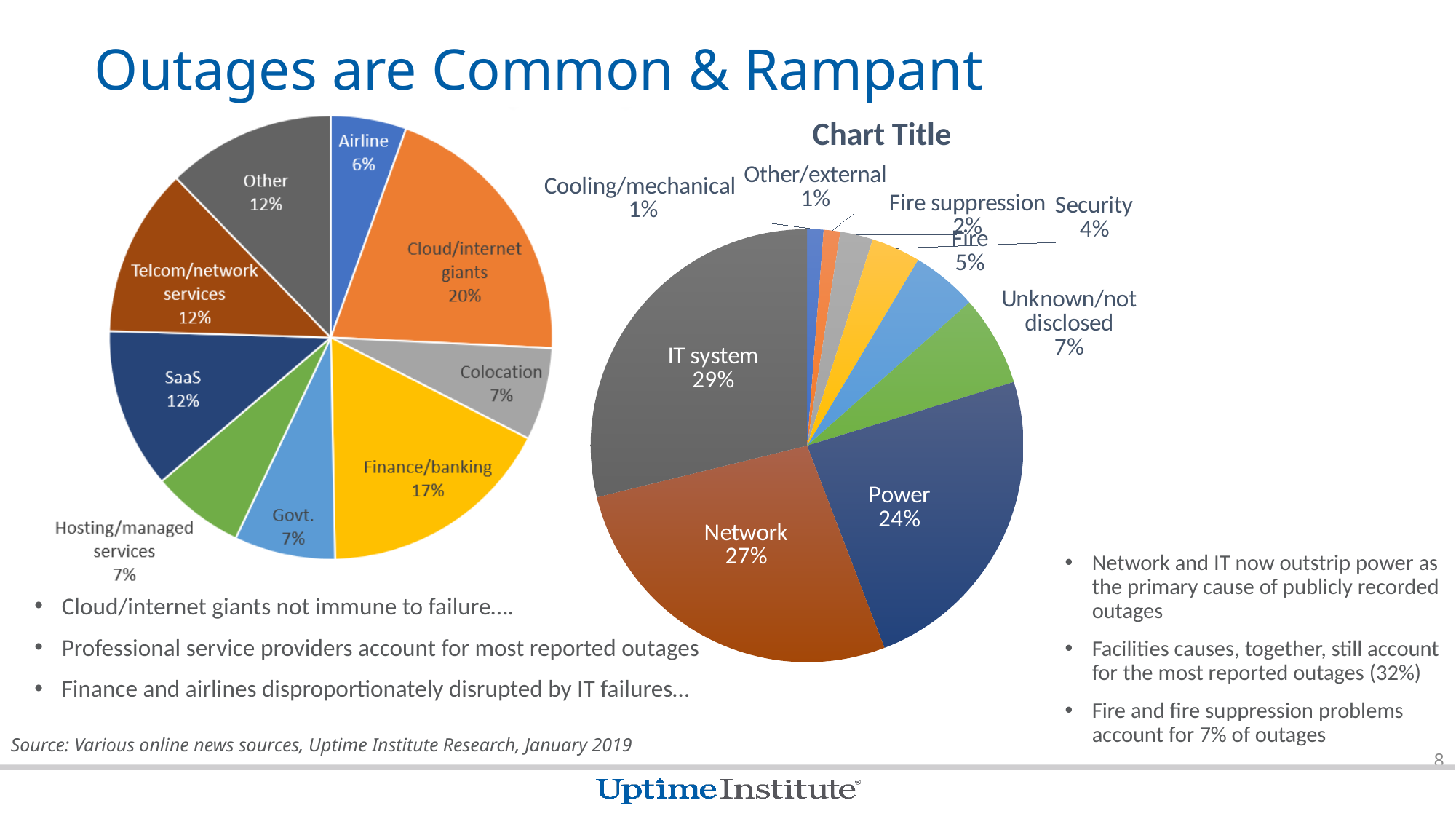
In the right pie chart, which cause has the largest share? IT system How many categories does the right pie chart show? 9 What type of chart is the right chart on the slide? Pie chart How many categories does the left pie chart show? 9 In the left pie chart, which is larger: SaaS or Colocation? SaaS In the right pie chart, which is larger: Fire or Security? Fire In the right pie chart, what is the difference between the Network share and the Power share? 3% In the left pie chart, what share do Cloud/internet giants account for? 20% In the left pie chart, what is the difference between the Finance/banking share and the Govt. share? 10% In the right pie chart, what share is attributed to Power? 24% In the left pie chart, which category has the largest share? Cloud/internet giants In the left pie chart, which category has the smallest share? Airline